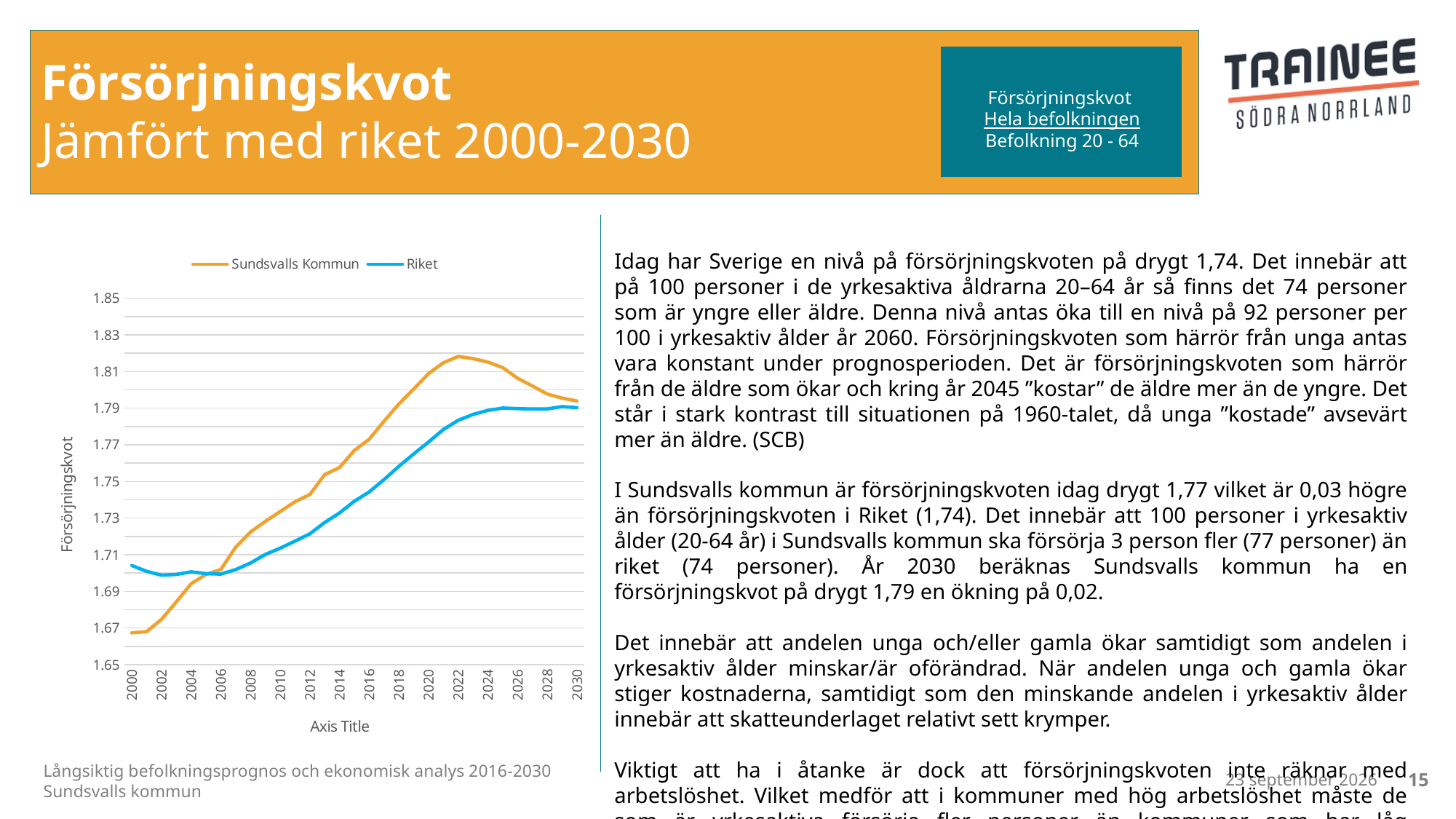
In 2000, which series has the higher value, Sundsvalls Kommun or Riket? Riket What kind of chart is shown on the slide? Line chart Is the value for Sundsvalls Kommun in 2022 greater or less than 1.81? greater Does the Sundsvalls Kommun line rise or fall between 2022 and 2030? Fall How many year labels are shown on the x axis of the chart? 16 What is the title of the vertical axis of the chart? Försörjningskvot How many series does the chart legend list? 2 In 2022, which series has the higher value, Sundsvalls Kommun or Riket? Sundsvalls Kommun Is the value for Riket in 2016 greater or less than 1.73? greater Is the value for Riket in 2000 greater or less than 1.69? greater Which series reaches the highest value anywhere on the chart? Sundsvalls Kommun Which two series are listed in the chart legend? Sundsvalls Kommun and Riket